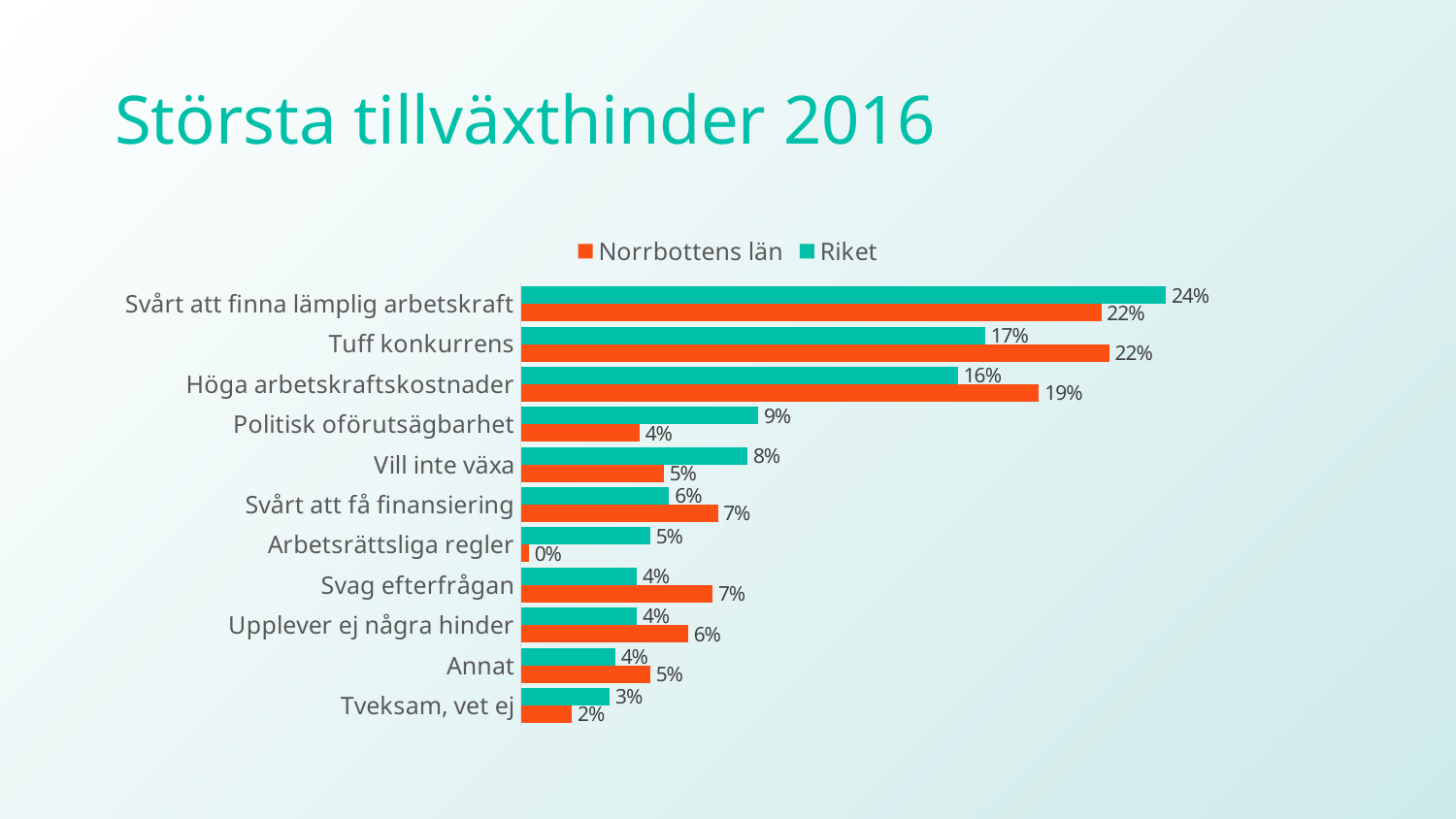
How many series does the legend list? 2 What is the value for Norrbottens län for "Tuff konkurrens"? 22% What is the value for Norrbottens län for "Arbetsrättsliga regler"? 0% What is the title of the slide? Största tillväxthinder 2016 Which category has the lowest value for Riket? Tveksam, vet ej For "Politisk oförutsägbarhet", which is larger: Norrbottens län or Riket? Riket What is the value for Riket for "Politisk oförutsägbarhet"? 9% What is the value for Riket for "Svårt att finna lämplig arbetskraft"? 24% Which category has the highest value for Norrbottens län? Svårt att finna lämplig arbetskraft and Tuff konkurrens (both 22%) What is the difference between Norrbottens län and Riket for "Tuff konkurrens"? 5 percentage points What kind of chart is shown on the slide? Bar chart How many categories are shown in the chart? 11